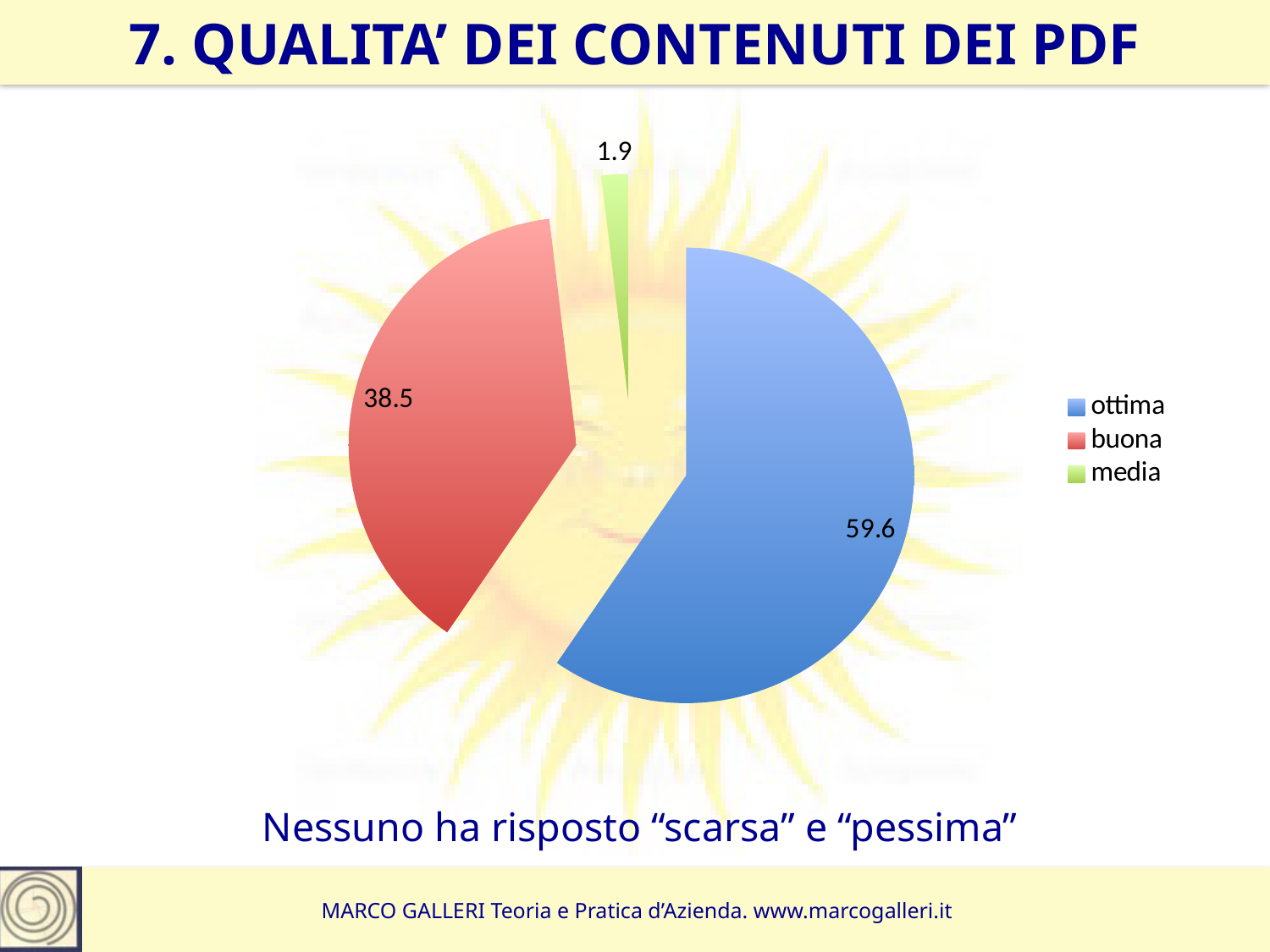
What is the value for "buona"? 38.5 Which is larger, the value for "buona" or the value for "media"? buona What is the difference between the values for "ottima" and "buona"? 21.1 Which category has the largest slice? ottima How many entries does the legend list? 3 What colour is the slice for "buona"? red What is the value for "media"? 1.9 Which category has the smallest slice? media What type of chart is shown on the slide? pie chart How many slices does the pie chart have? 3 What is the value for "ottima"? 59.6 What is the title of the slide containing the chart? 7. QUALITA' DEI CONTENUTI DEI PDF